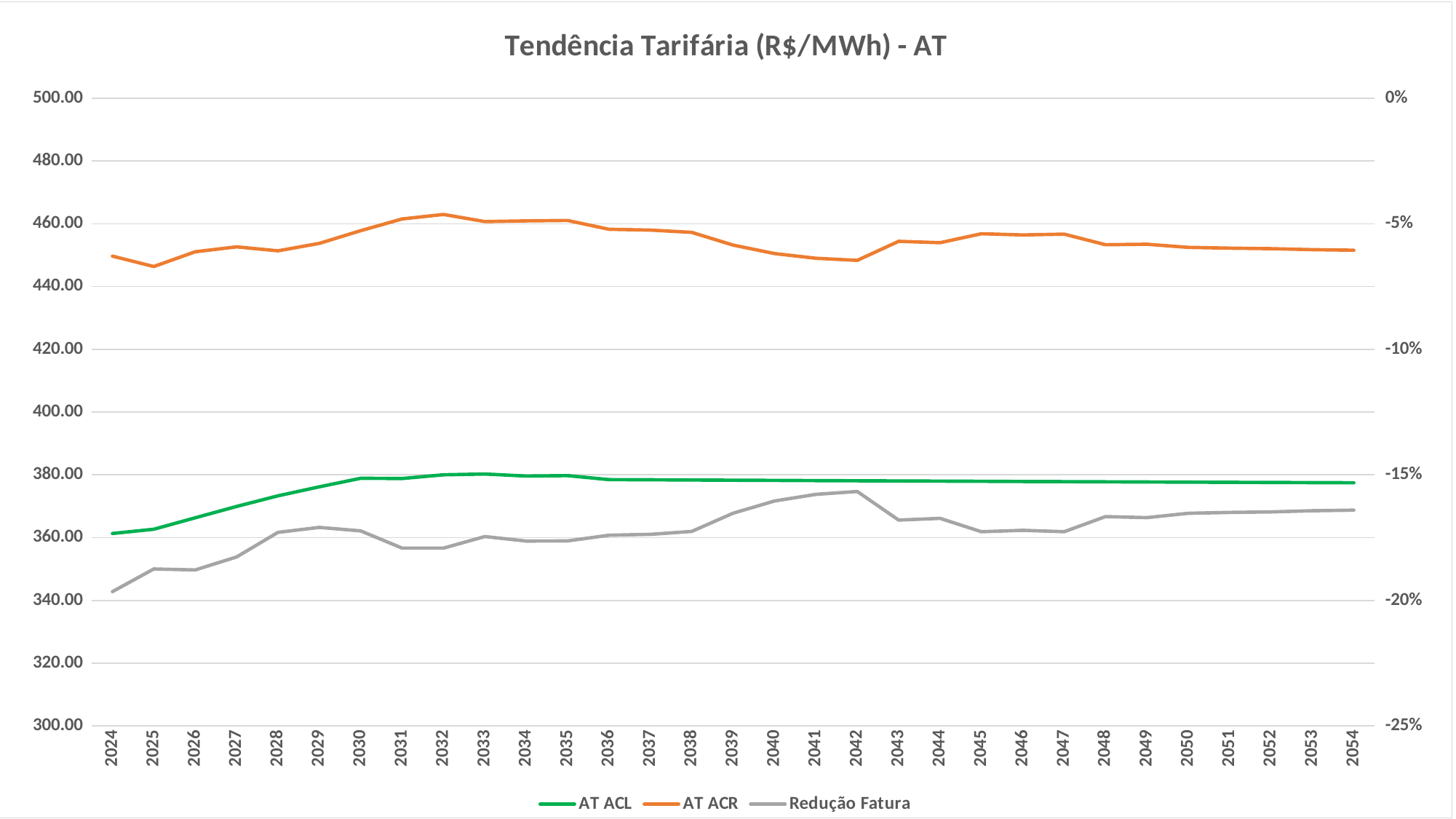
Is the value for AT ACR in 2024 greater or less than 440.00? greater Which colour is used for the AT ACL series? green What kind of chart is shown on the slide? line chart What is the title of the chart? Tendência Tarifária (R$/MWh) - AT How many years are plotted along the x axis? 31 In which year is the AT ACL series at its lowest? 2024 In 2030, which series has the larger value, AT ACR or AT ACL? AT ACR Is the value for AT ACL in 2024 greater or less than 380.00? less Is the value for Redução Fatura in 2024 greater or less than -15%? less How many series does the legend list? 3 Does the AT ACL series rise or fall from 2024 to 2030? rise